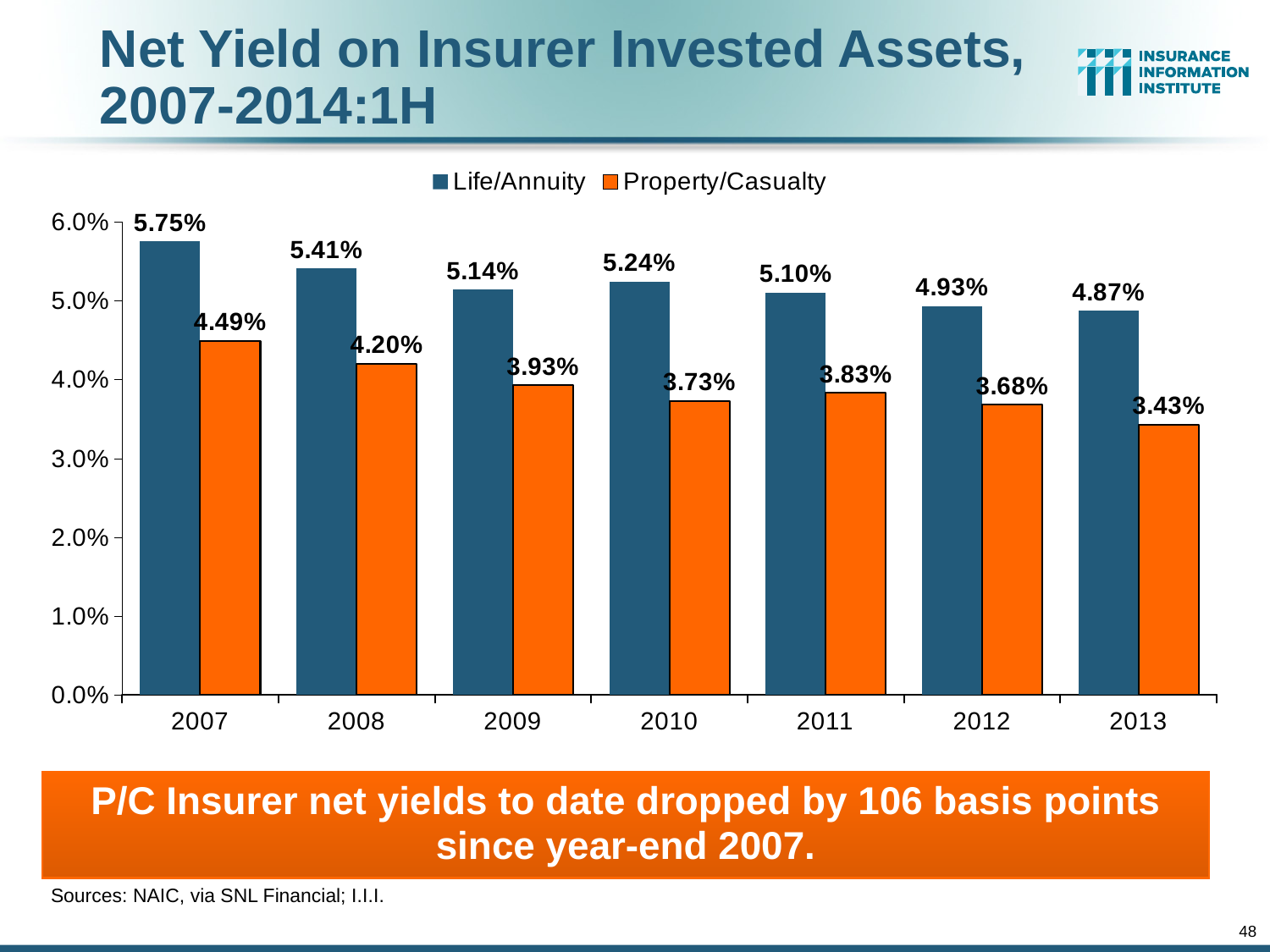
Which is larger, the Property/Casualty net yield in 2009 or in 2011? 2009 Is the Property/Casualty net yield for 2008 greater or less than 4.0%? greater What is the Property/Casualty net yield for 2010? 3.73% Does the Property/Casualty net yield generally rise or fall from 2007 to 2013? Fall What is the difference between the Life/Annuity and Property/Casualty net yields in 2012? 1.25% What kind of chart is shown on the slide? Bar chart How many years are shown on the x axis? 7 What is the Life/Annuity net yield for 2007? 5.75% Which year has the highest Life/Annuity net yield? 2007 Which year has the lowest Property/Casualty net yield? 2013 How many series does the legend list? 2 What is the Property/Casualty net yield for 2013? 3.43%